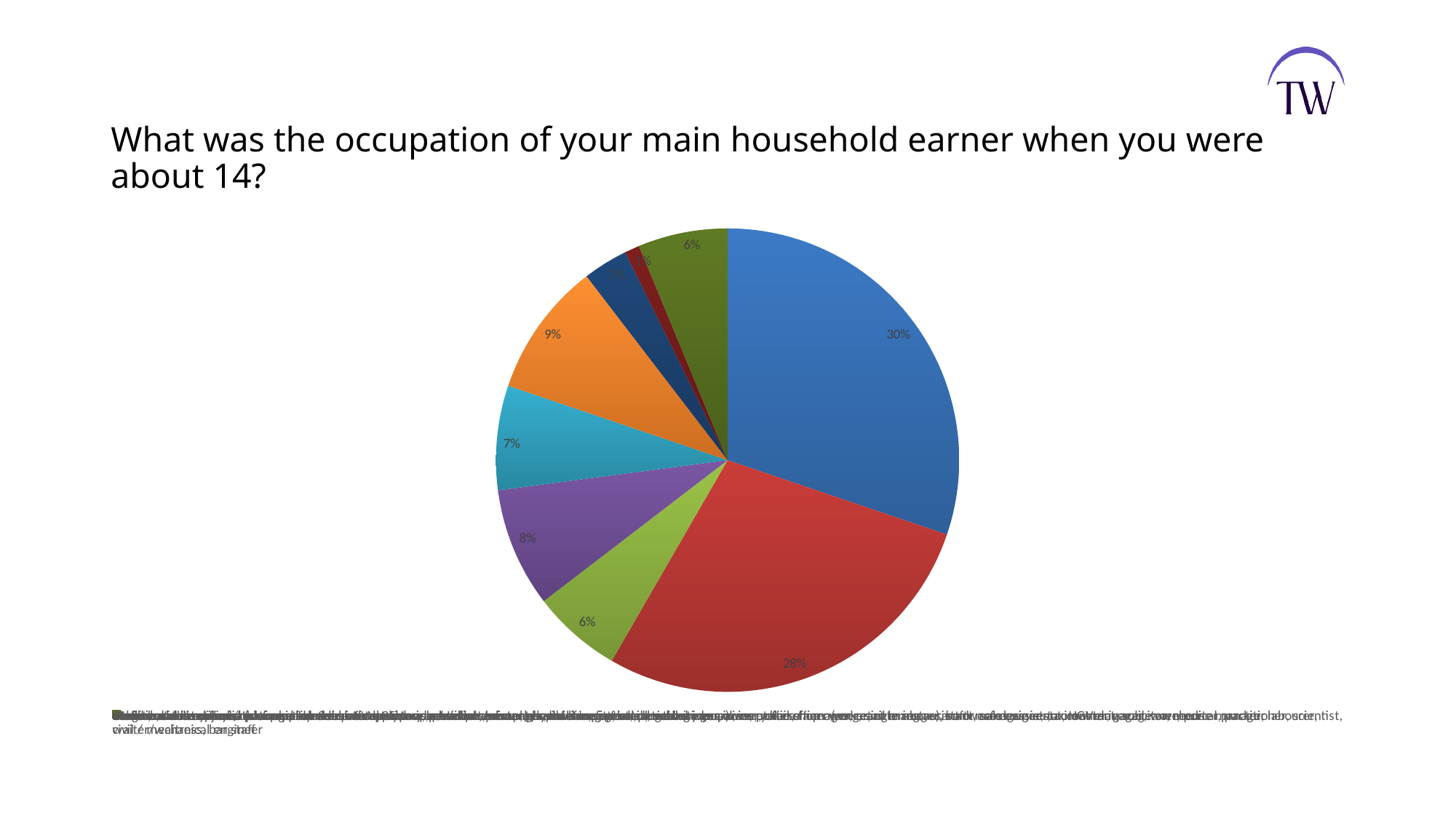
What percentage is shown on the dark blue slice of the pie chart? 3% What kind of chart is shown on the slide? pie chart What percentage is shown on the purple slice of the pie chart? 8% By how many percentage points does the blue slice exceed the red slice? 2 percentage points What is the largest percentage shown on any slice of the pie chart? 30% What percentage is shown on the red slice of the pie chart? 28% What percentage is shown on the teal slice of the pie chart? 7% How many slices does the pie chart have? 9 Which slice is larger, the orange slice or the purple slice? the orange slice What percentage is shown on the blue slice of the pie chart? 30% What percentage is shown on the orange slice of the pie chart? 9% What is the title of the chart on the slide? What was the occupation of your main household earner when you were about 14?